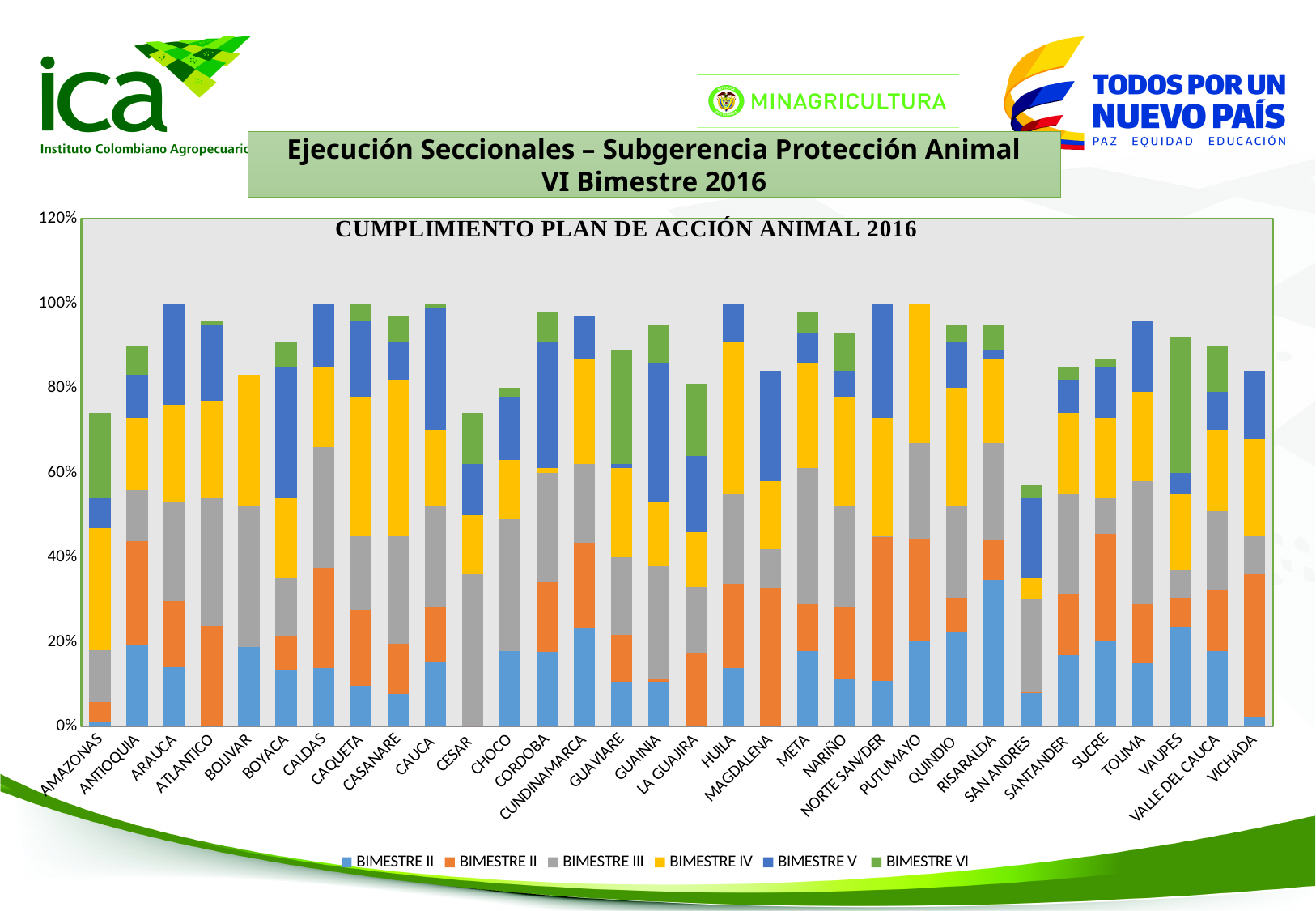
How many series does the legend list? 6 Which has the larger total stacked bar, ANTIOQUIA or CESAR? ANTIOQUIA What colour represents BIMESTRE VI in the legend? green How many categories (seccionales) are shown on the x axis? 32 Is the total for AMAZONAS greater or less than 80%? less Is the total for CESAR greater or less than 80%? less Which has the larger total stacked bar, AMAZONAS or SAN ANDRES? AMAZONAS Which category has the lowest total stacked bar? SAN ANDRES Is the total for VAUPES greater or less than 80%? greater What kind of chart is shown on the slide? stacked bar chart What is the title of the chart? CUMPLIMIENTO PLAN DE ACCIÓN ANIMAL 2016